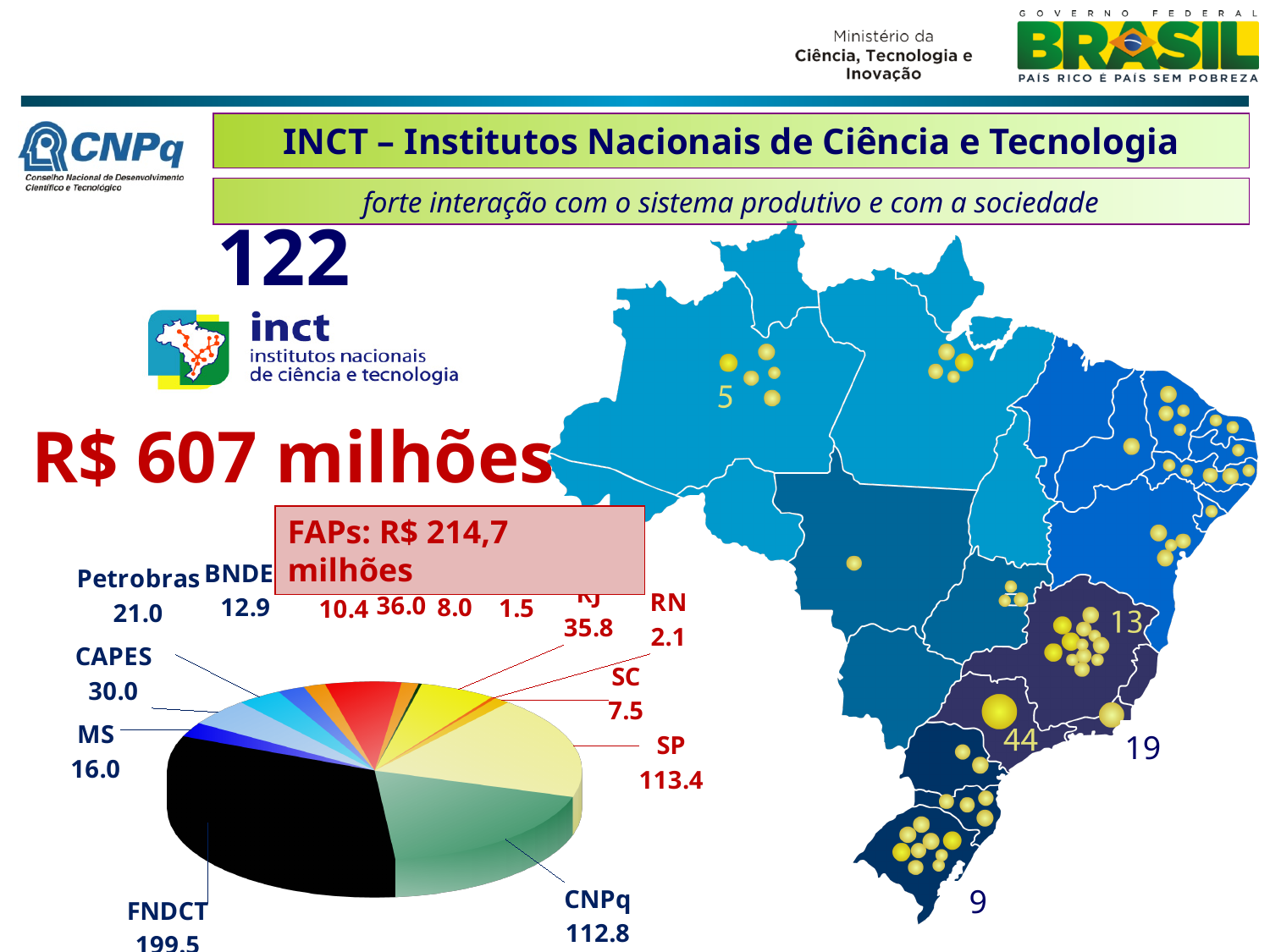
What is the value for FNDCT in the pie chart? 199.5 Which category has the largest slice in the pie chart? FNDCT What is the difference between the CAPES and MS values in the pie chart? 14.0 What is the difference between the FNDCT and SP values in the pie chart? 86.1 What is the value for CNPq in the pie chart? 112.8 What is the value for SP in the pie chart? 113.4 What is the value for Petrobras in the pie chart? 21.0 Which is larger in the pie chart, CAPES or Petrobras? CAPES What is the value for CAPES in the pie chart? 30.0 What is the value for MS in the pie chart? 16.0 What is the value for RJ in the pie chart? 35.8 What kind of chart is shown on the slide? pie chart